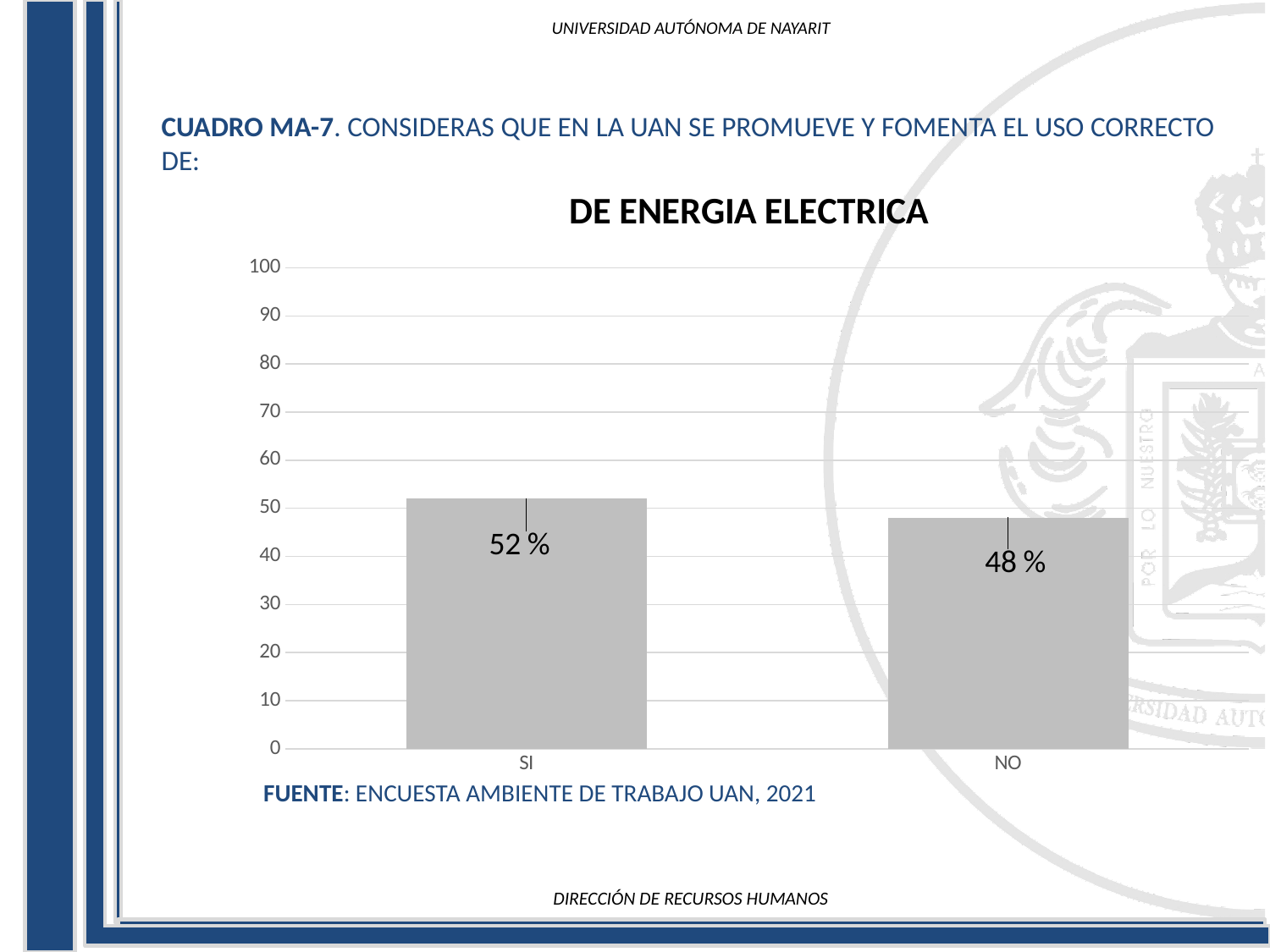
What is the value for NO? 48 % Is the value for SI greater or less than 50? greater What is the difference between the values for SI and NO? 4 % Which is larger, the value for SI or the value for NO? SI Is the value for NO greater or less than 50? less What kind of chart is shown on the slide? bar chart Which category has the lowest value? NO How many categories are shown on the x axis? 2 What is the title of the chart? DE ENERGIA ELECTRICA Which category has the highest value? SI What is the value for SI? 52 % What is the maximum value shown on the y axis? 100